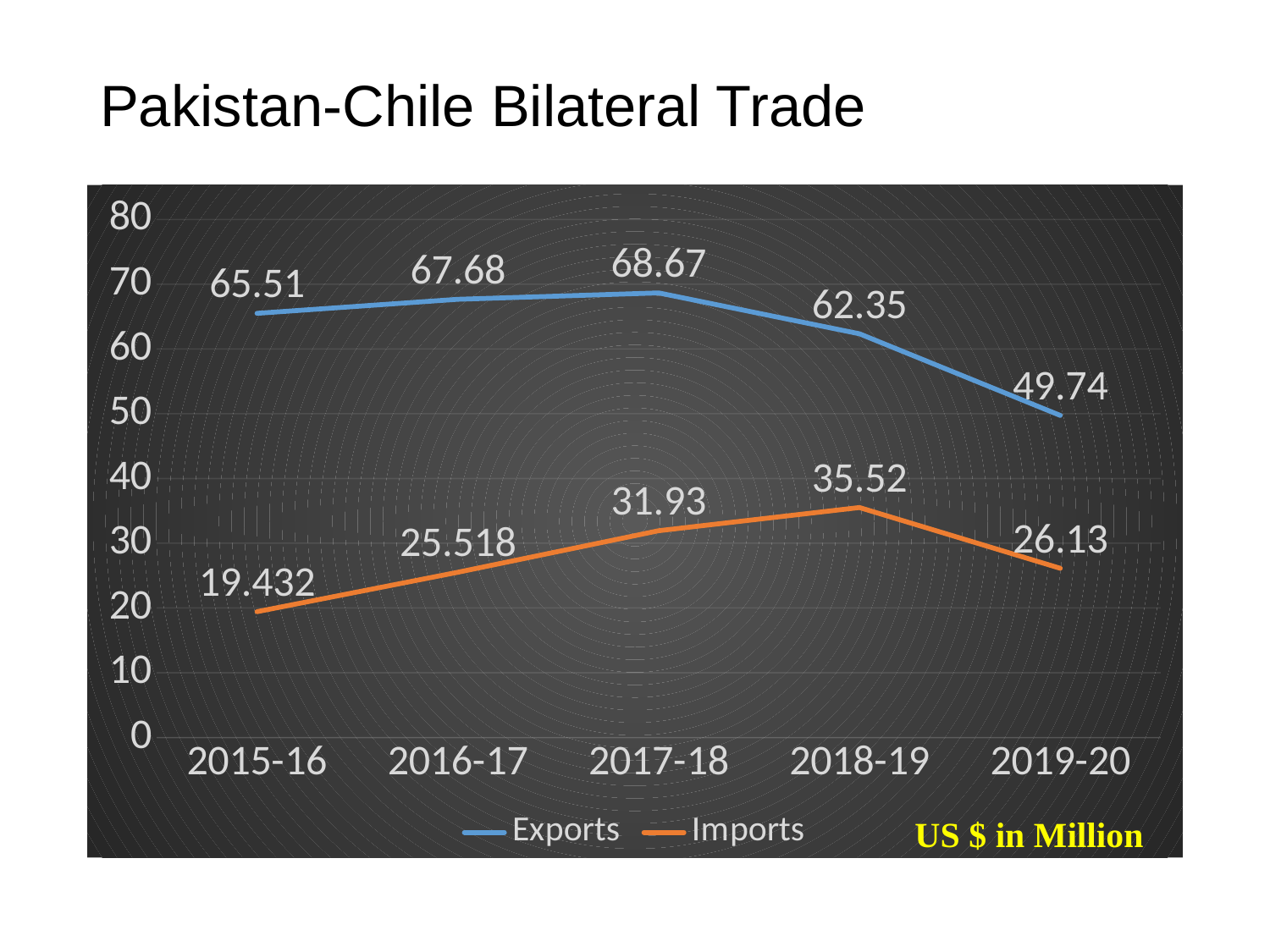
How many series does the legend list? 2 In which year are Exports highest? 2017-18 What is the value of Imports in 2015-16? 19.432 In which year are Imports lowest? 2015-16 Which is larger, Exports in 2016-17 or Exports in 2019-20? Exports in 2016-17 What is the value of Exports in 2017-18? 68.67 How many years are shown on the x axis? 5 What kind of chart is shown? Line chart Is the value of Imports in 2018-19 greater or less than 30? greater Do Exports rise or fall from 2017-18 to 2019-20? Fall What is the difference between Exports and Imports in 2018-19? 26.83 What is the value of Imports in 2019-20? 26.13